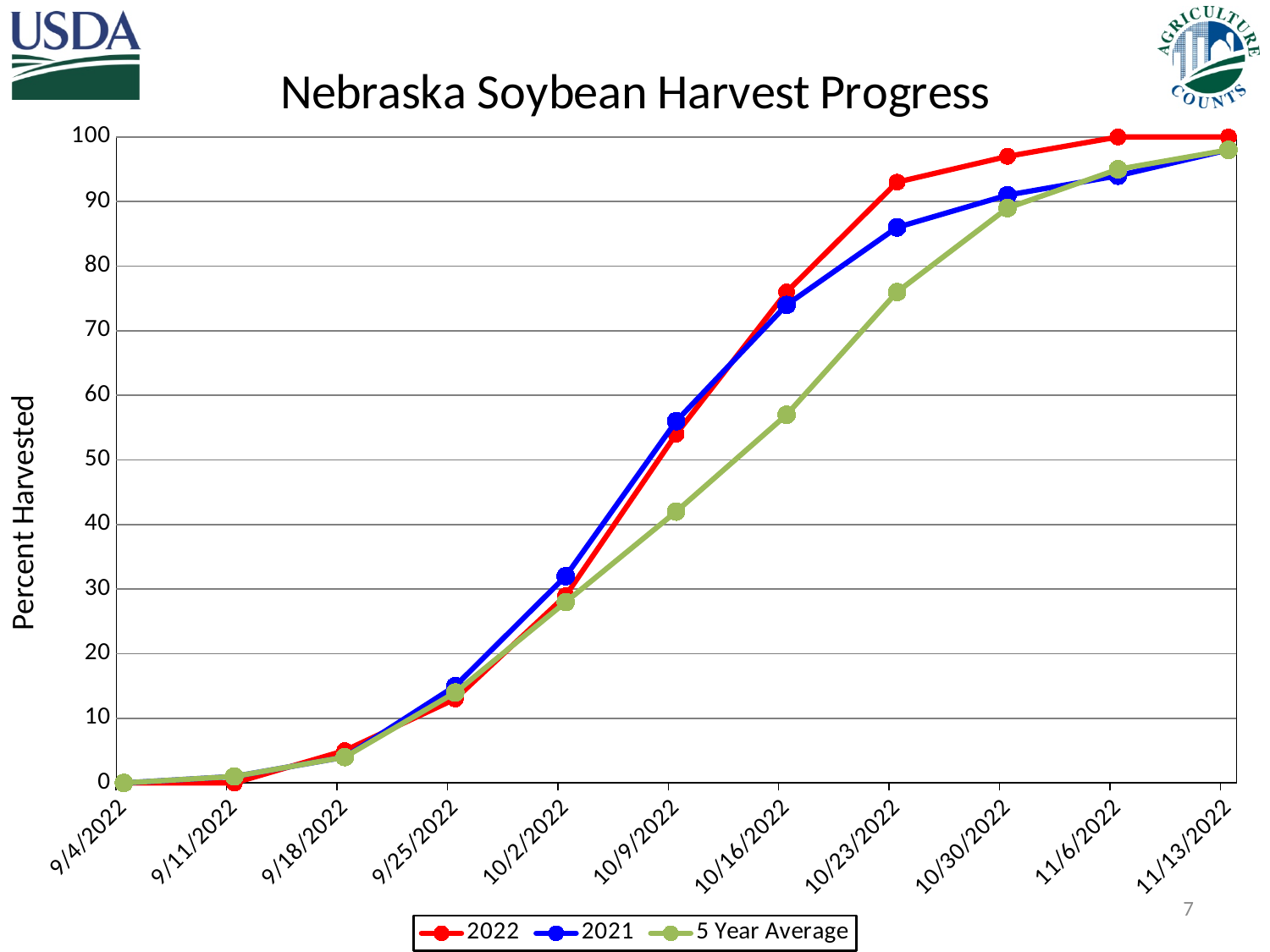
Do the values for the 2022 series rise or fall from 9/4/2022 to 11/13/2022? rise What is the label on the y axis? Percent Harvested On 10/23/2022, which series has the higher value, 2022 or 5 Year Average? 2022 Is the value for the 5 Year Average on 10/23/2022 greater or less than 70? greater Is the value for 2021 on 10/16/2022 greater or less than 70? greater How many dates are plotted along the x axis? 11 What kind of chart is shown on the slide? line chart Is the value for the 5 Year Average on 10/16/2022 greater or less than 60? less What is the value for 2022 on 11/13/2022? 100 Which series has the highest value on 10/23/2022? 2022 How many series does the legend list? 3 What is the title of the chart? Nebraska Soybean Harvest Progress